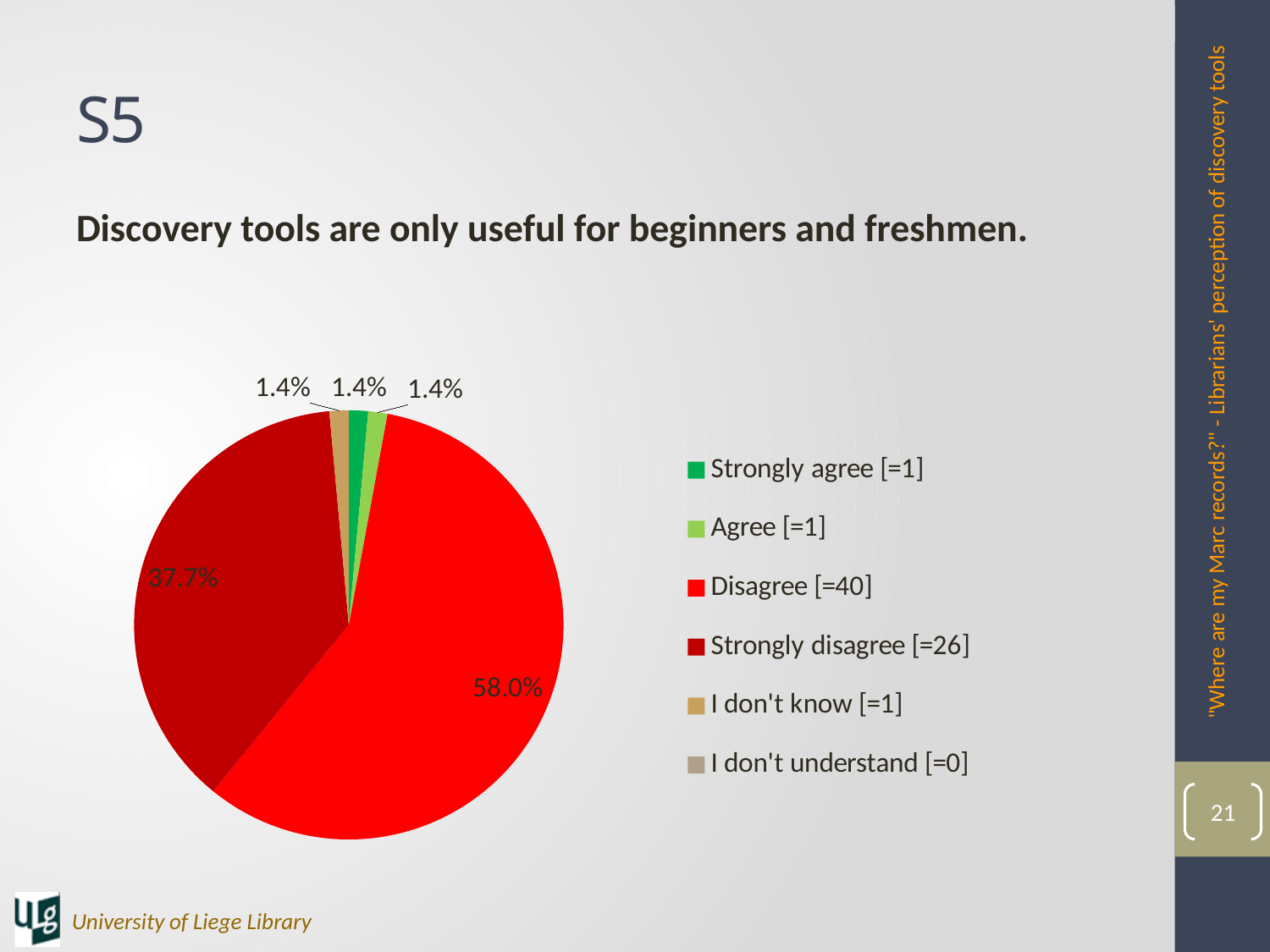
What percentage of the pie is labelled for Strongly disagree? 37.7% What kind of chart is shown on the slide? pie chart What percentage of the pie is labelled for Disagree? 58.0% How many respondents chose Disagree, according to the legend? 40 How many respondents chose Strongly disagree, according to the legend? 26 What percentage of the pie is labelled for Agree? 1.4% How many entries does the legend list? 6 Which response category has the largest slice of the pie? Disagree Which legend entry has a count of 0? I don't understand What is the difference in percentage points between the Disagree and Strongly disagree slices? 20.3 Which slice is larger, Disagree or Strongly disagree? Disagree What colour is the Disagree slice? red